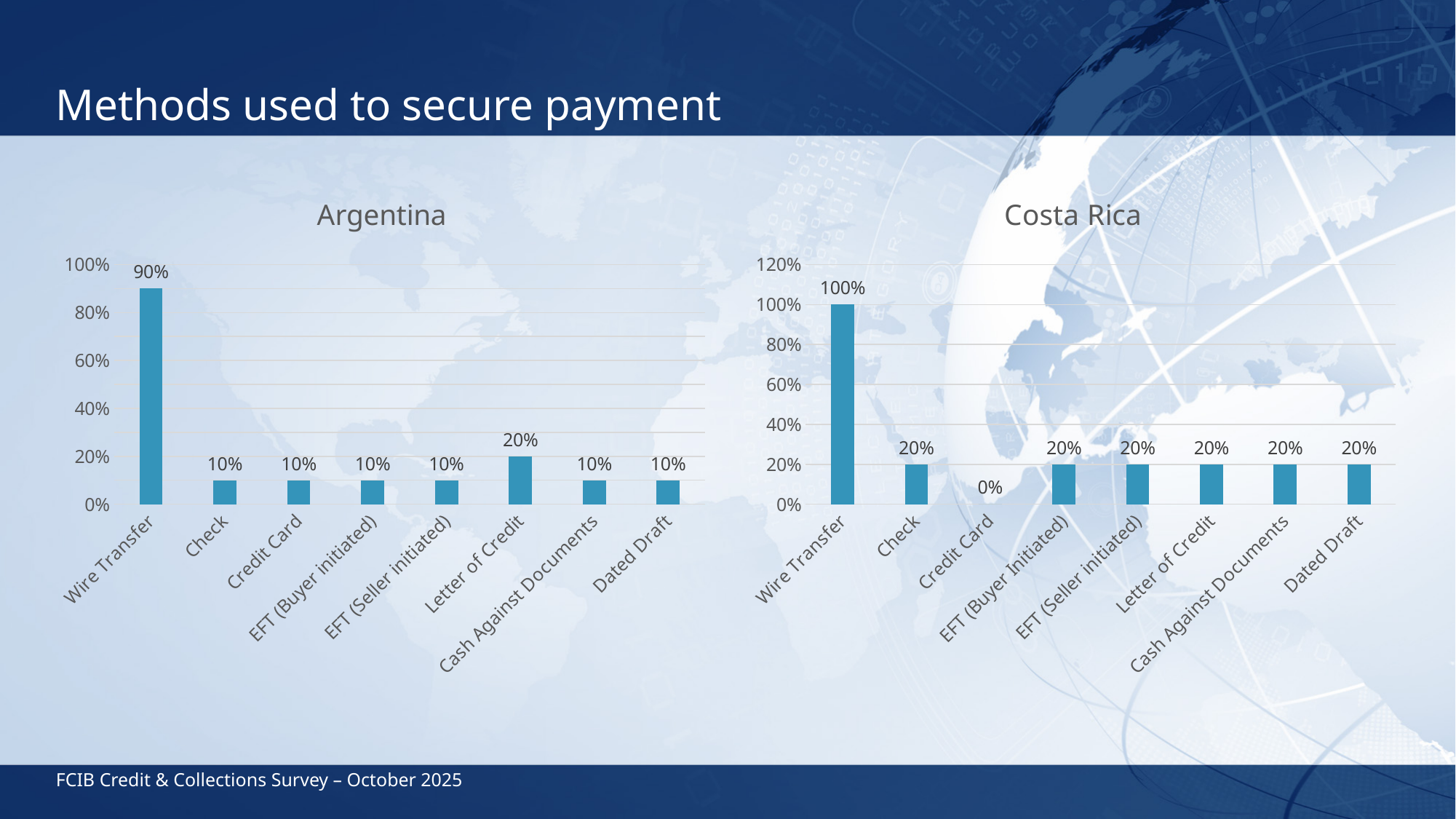
In the Argentina chart, what is the value for Wire Transfer? 90% What is the title of the chart on the right side of the slide? Costa Rica What kind of chart is the Argentina chart? Bar chart In the Argentina chart, what is the difference between Wire Transfer and Check? 80% In the Costa Rica chart, what is the value for Credit Card? 0% In the Costa Rica chart, what is the value for Wire Transfer? 100% In the Costa Rica chart, which category has the lowest value? Credit Card In the Argentina chart, which is larger, Letter of Credit or Credit Card? Letter of Credit In the Costa Rica chart, what is the difference between Wire Transfer and Dated Draft? 80% In the Argentina chart, which category has the highest value? Wire Transfer How many categories are shown in the Costa Rica chart? 8 In the Argentina chart, what is the value for Letter of Credit? 20%